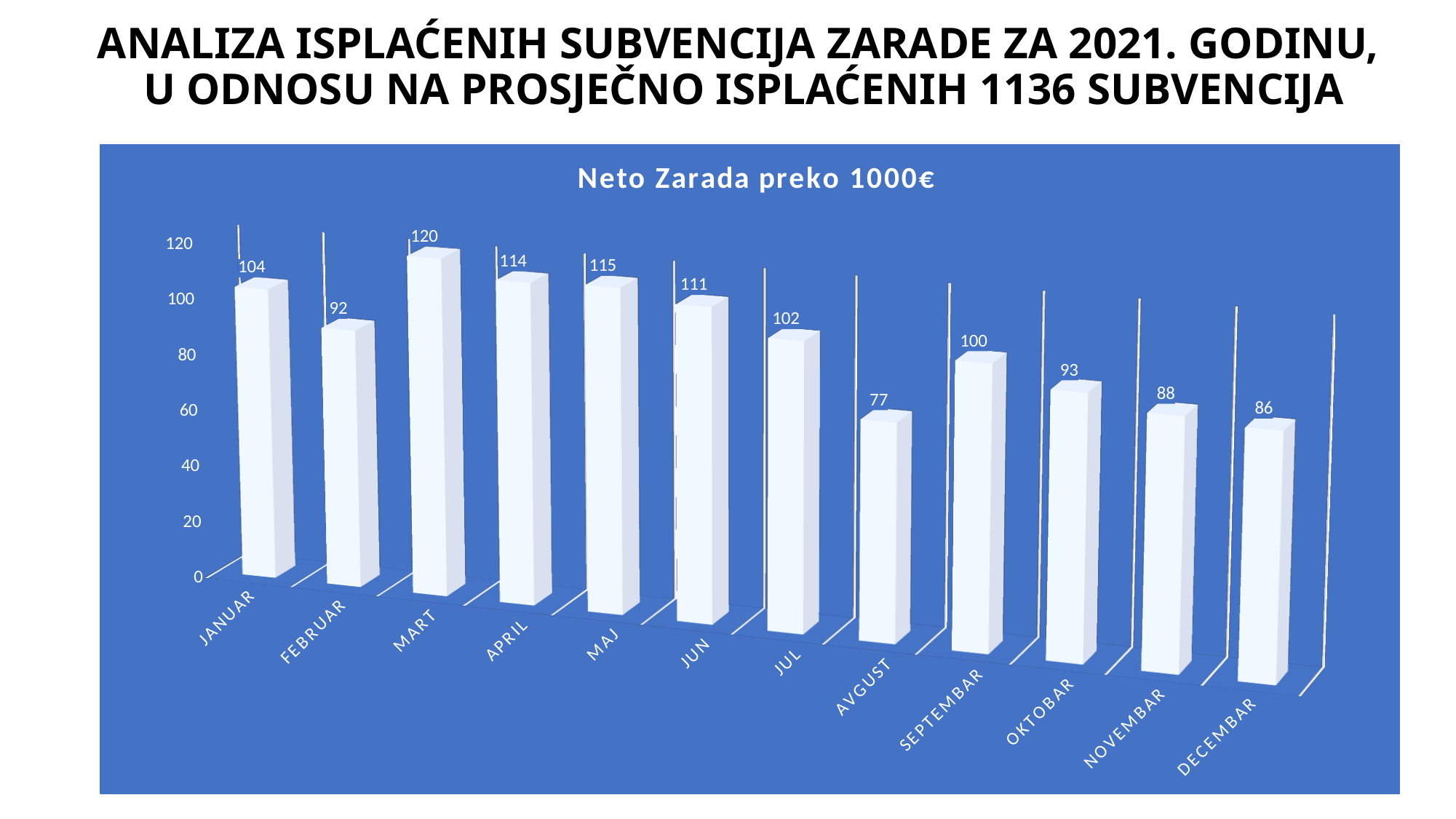
What is the value for SEPTEMBAR? 100 Is the value for DECEMBAR greater or less than 100? less What is the difference between the values for JANUAR and FEBRUAR? 12 What is the title of the chart? Neto Zarada preko 1000€ Which month has the highest value? MART Which month has the lowest value? AVGUST What is the value for MART? 120 How many months are shown on the chart? 12 What kind of chart is shown on the slide? bar chart What is the difference between the values for MART and AVGUST? 43 What is the value for AVGUST? 77 Which is larger, the value for JUN or the value for JUL? JUN